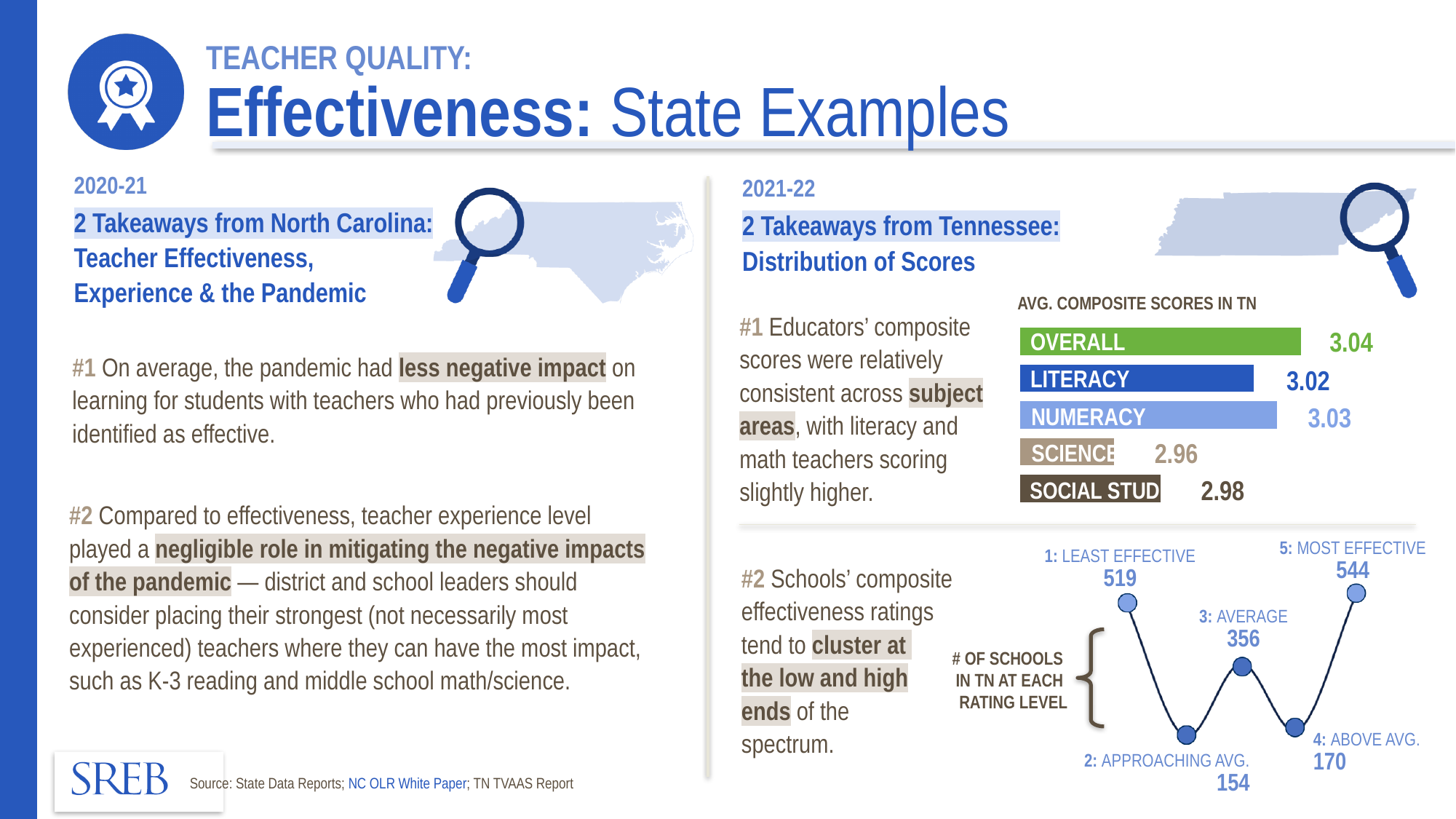
In the '# of Schools in TN at Each Rating Level' chart, how many schools are at the 'Most Effective' rating level? 544 What type of chart is the '# of Schools in TN at Each Rating Level' chart? Line chart In the 'Avg. Composite Scores in TN' chart, which is higher, the Literacy score or the Social Studies score? Literacy How many bars are shown in the 'Avg. Composite Scores in TN' chart? 5 How many rating levels are plotted in the '# of Schools in TN at Each Rating Level' chart? 5 In the 'Avg. Composite Scores in TN' chart, which subject area has the lowest average composite score? Science In the 'Avg. Composite Scores in TN' chart, what is the average composite score for Science? 2.96 In the 'Avg. Composite Scores in TN' chart, what is the Overall average composite score? 3.04 In the '# of Schools in TN at Each Rating Level' chart, which rating level has the fewest schools? 2: Approaching Avg. In the 'Avg. Composite Scores in TN' chart, what is the difference between the Numeracy and Literacy scores? 0.01 In the '# of Schools in TN at Each Rating Level' chart, what is the difference between the number of schools rated 'Least Effective' and 'Average'? 163 What type of chart is the 'Avg. Composite Scores in TN' chart? Bar chart